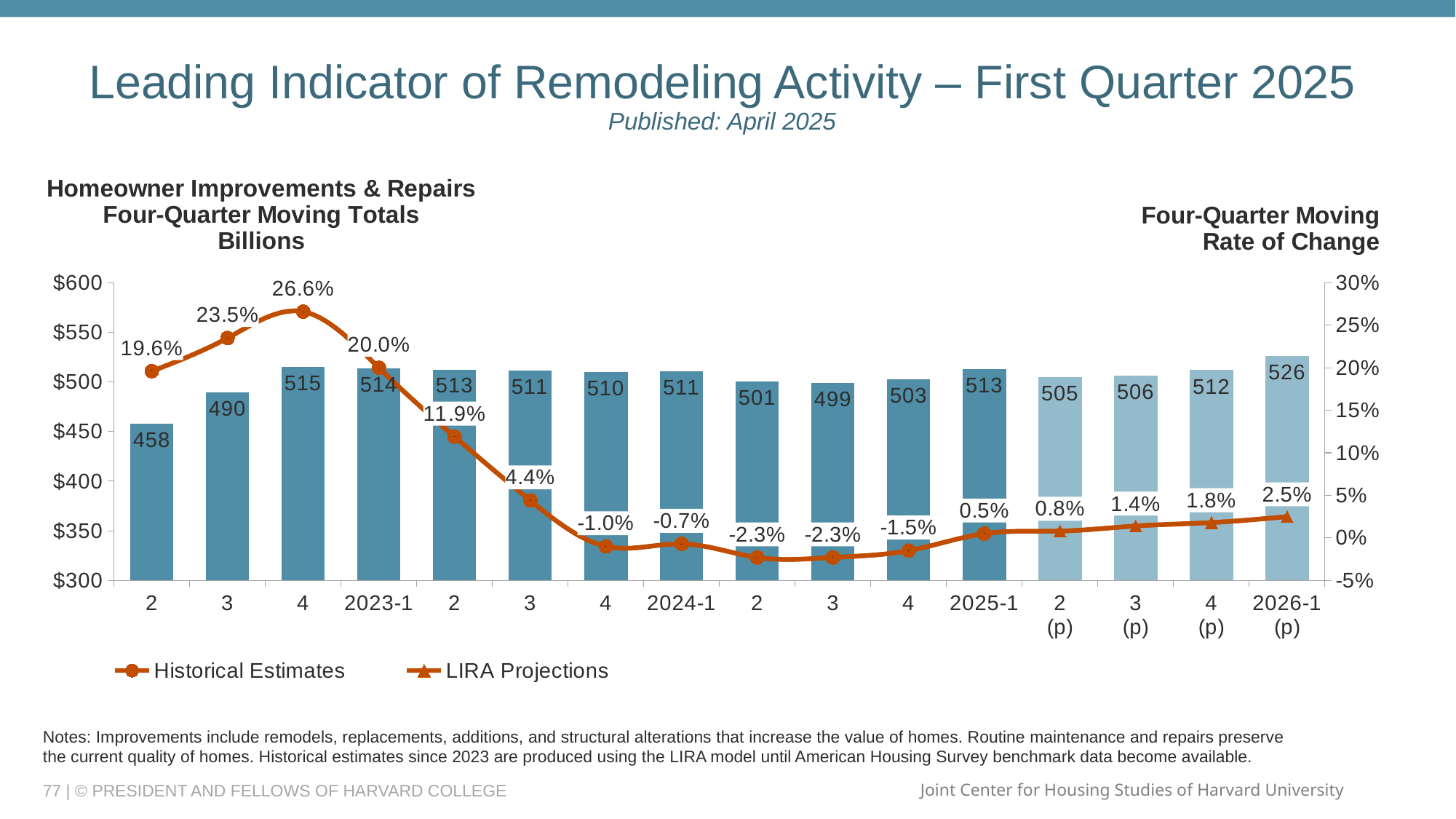
Which quarter has the highest four-quarter moving rate of change on the line? 4 (the third point, 26.6%) What is the difference between the four-quarter moving total for 2026-1 (p) and for 2025-1? 13 How many quarters (bars) are plotted on the chart? 16 What is the four-quarter moving total (in billions) shown for 2025-1? 513 Does the rate-of-change line rise or fall from 2023-1 to 2024-1? Fall What kind of chart is shown on the slide? Combined bar and line chart Which is larger, the four-quarter moving total for 2023-1 or for 2024-1? 2023-1 Which quarter has the lowest four-quarter moving total bar? 2 (the first bar, 458) What four-quarter moving rate of change is labeled for 2024-1? -0.7% How many series does the legend list? 2 What are the two series named in the legend? Historical Estimates and LIRA Projections What is the projected four-quarter moving total for 2026-1 (p)? 526